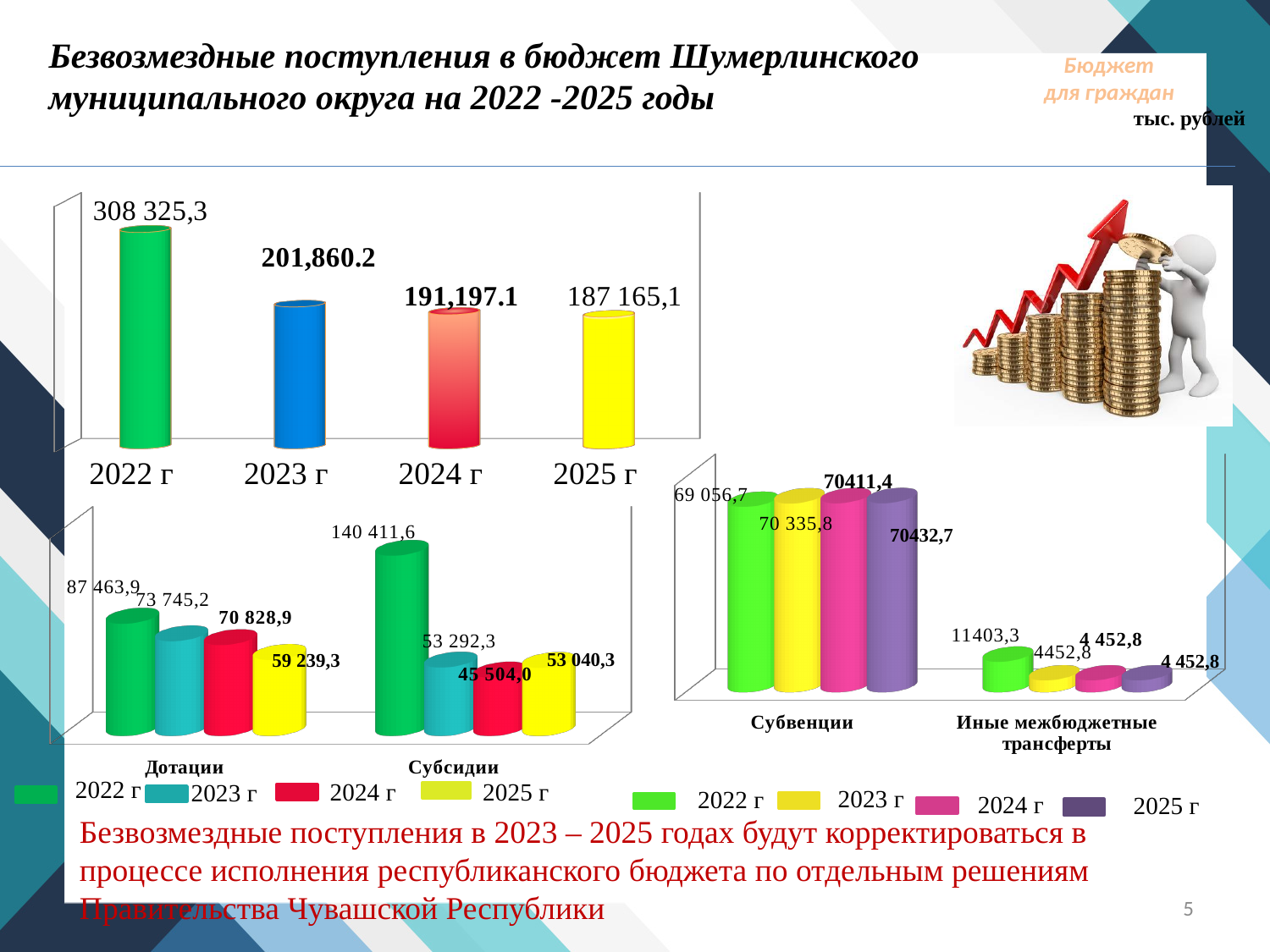
In the top-left chart, what is the value for 2022 г? 308 325,3 In the top-left chart, do the values rise or fall from 2022 г to 2025 г? fall In the bottom-right chart, which is larger: Субвенции for 2022 г or Субвенции for 2025 г? 2025 г In the bottom-right chart, what is the value of Иные межбюджетные трансферты for 2022 г? 11403,3 In the bottom-left chart, what is the value of Субсидии for 2022 г? 140 411,6 In the bottom-left chart, what is the value of Дотации for 2025 г? 59 239,3 In the top-left chart, how many bars are plotted? 4 In the top-left chart, what is the difference between the values for 2022 г and 2025 г? 121 160,2 In the top-left chart, what is the value for 2025 г? 187 165,1 In the top-left chart, which year has the highest value? 2022 г In the bottom-left chart, how many series does the legend list? 4 In the bottom-left chart, which year has the lowest value for Субсидии? 2024 г